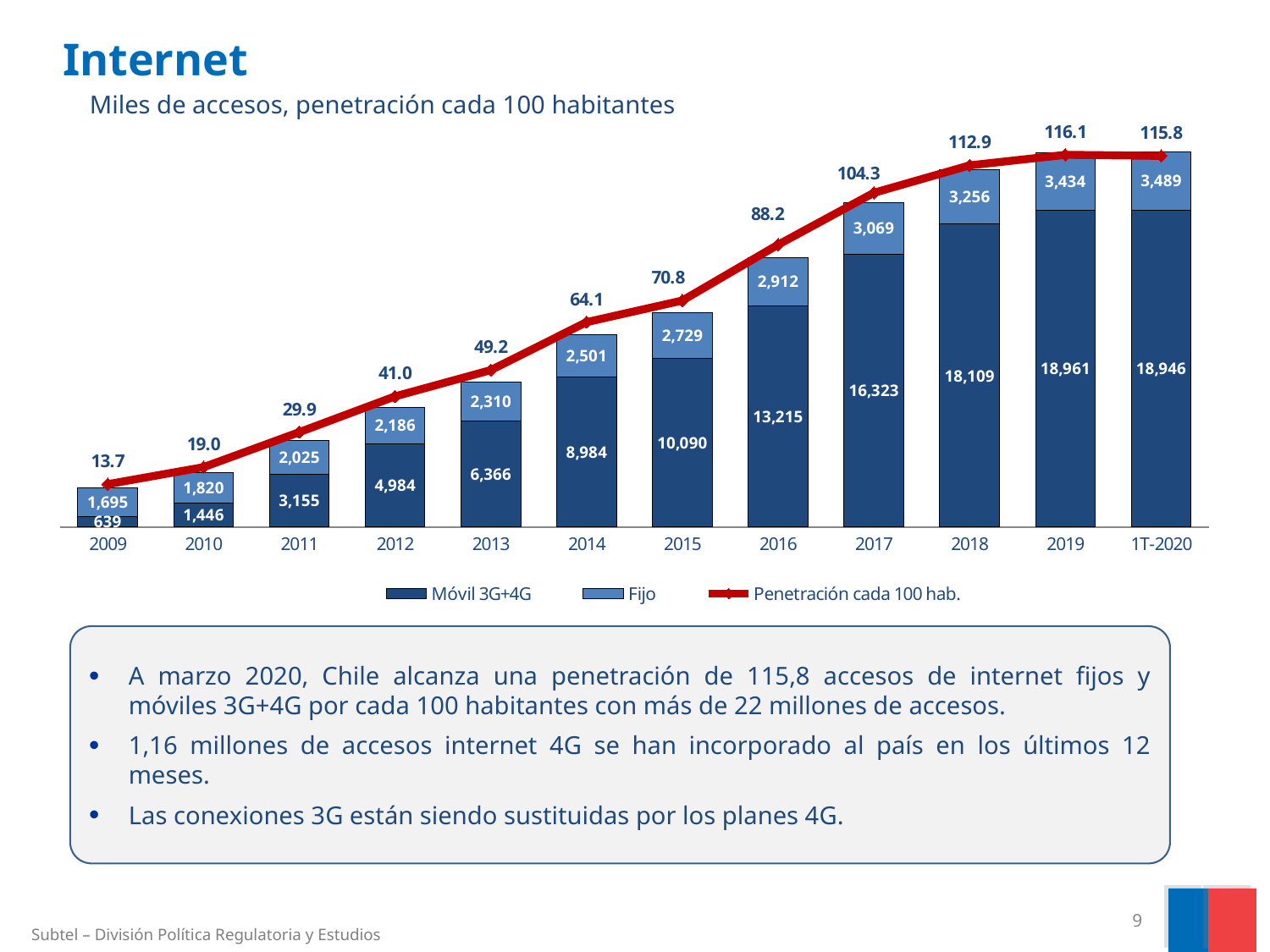
Does the Fijo value rise or fall from 2009 to 1T-2020? Rise What kind of chart is this? Stacked bar chart with a line How many periods are shown on the x axis? 12 In which year is the Móvil 3G+4G value lowest? 2009 In which year is the Penetración cada 100 hab. value highest? 2019 Which is larger, the Fijo value for 2019 or for 1T-2020? 1T-2020 What is the Fijo value for 2013? 2,310 What is the difference between the Móvil 3G+4G values for 2019 and 2018? 852 What is the total of the stacked bar for 1T-2020? 22,435 What is the Móvil 3G+4G value for 2016? 13,215 How many series does the legend list? 3 What is the Penetración cada 100 hab. value for 2017? 104.3